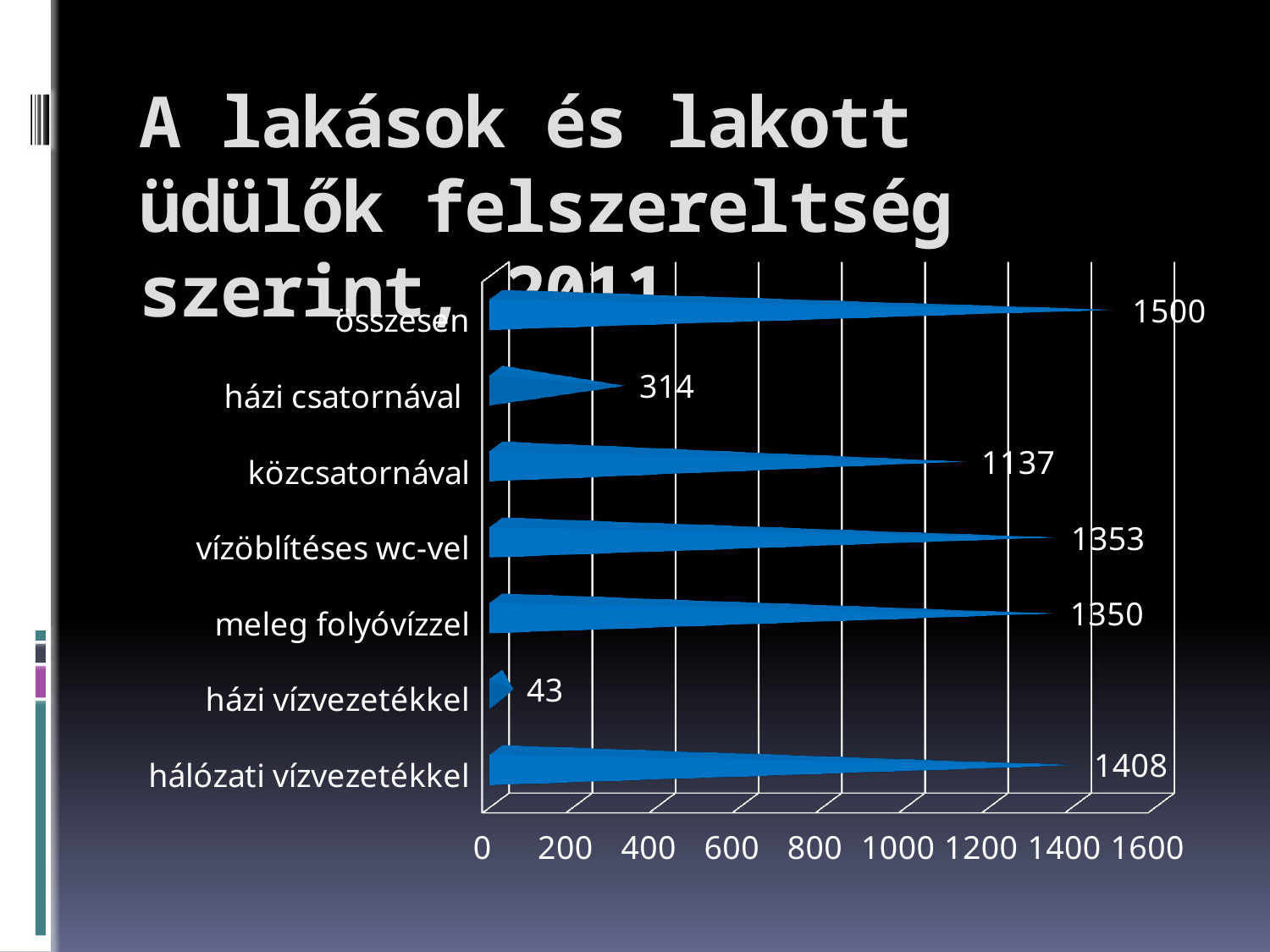
What is the value for házi vízvezetékkel? 43 Which category has the lowest value? házi vízvezetékkel What is the value for hálózati vízvezetékkel? 1408 Is the value for közcsatornával greater or less than 1000? greater How many categories are shown in the chart? 7 What is the difference between the values for vízöblítéses wc-vel and meleg folyóvízzel? 3 What is the value for közcsatornával? 1137 What is the value for házi csatornával? 314 What kind of chart is shown on the slide? bar chart Which category has the highest value? összesen Which is larger, the value for közcsatornával or the value for házi csatornával? közcsatornával What is the difference between the values for összesen and hálózati vízvezetékkel? 92